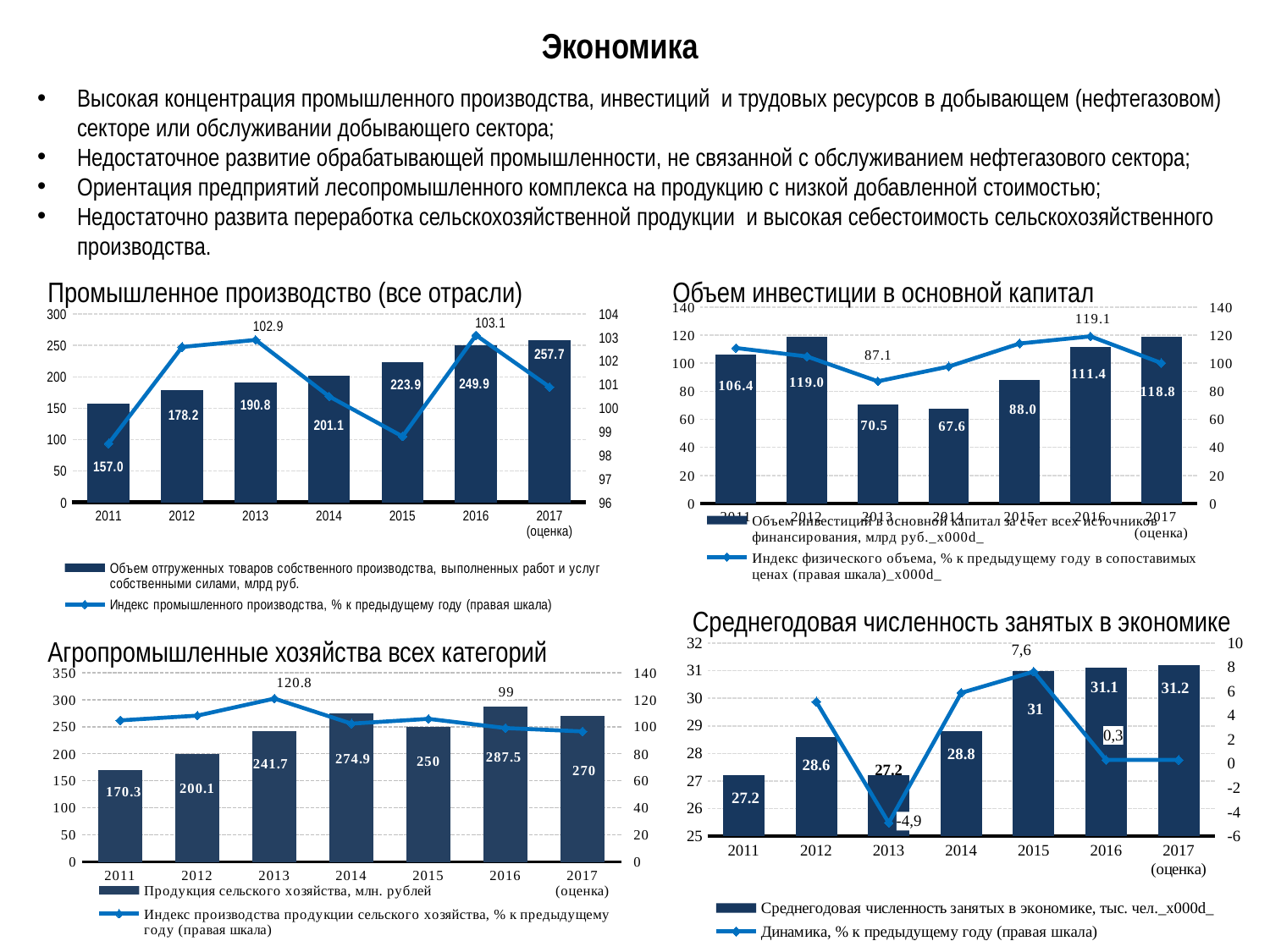
In the chart 'Среднегодовая численность занятых в экономике', what is the bar value for 2012? 28.6 In the chart 'Агропромышленные хозяйства всех категорий', what is the labelled line value for 2013? 120.8 In the chart 'Промышленное производство (все отрасли)', what is the value of the bar for 2015? 223.9 In the chart 'Объем инвестиции в основной капитал', what is the bar value for 2014? 67.6 In the chart 'Агропромышленные хозяйства всех категорий', what is the bar value for 2016? 287.5 In the chart 'Объем инвестиции в основной капитал', what is the labelled value of the line (index) for 2016? 119.1 In the chart 'Объем инвестиции в основной капитал', which year has the highest bar value? 2012 How many years (categories) are shown on the x axis of the chart 'Среднегодовая численность занятых в экономике'? 7 In the chart 'Промышленное производство (все отрасли)', which year has the lowest bar value? 2011 In the chart 'Промышленное производство (все отрасли)', what is the difference between the bar values for 2017 (оценка) and 2016? 7.8 In the chart 'Агропромышленные хозяйства всех категорий', which is larger: the bar for 2014 or the bar for 2015? 2014 In the chart 'Среднегодовая численность занятых в экономике', what is the labelled line value for 2013? -4,9